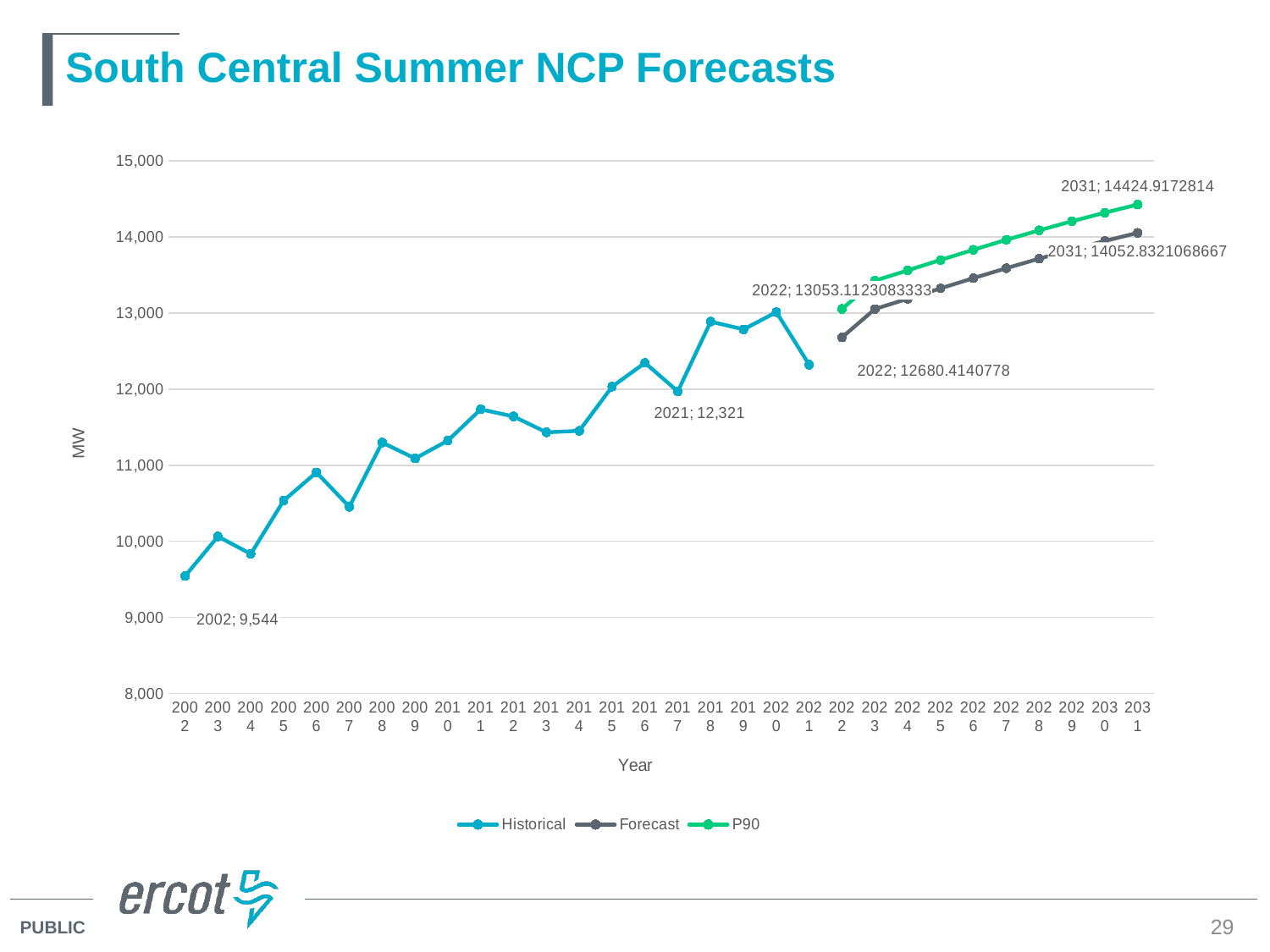
What is the Forecast value for 2022? 12680.4140778 Do the P90 values rise or fall from 2022 to 2031? Rise What kind of chart is shown on the slide? Line chart How many series does the legend list? 3 What is the Historical value for 2021? 12,321 What is the Historical value for 2002? 9,544 Is the Historical value for 2007 greater or less than 11,000? less What is the P90 value for 2022? 13053.1123083333 Is the Historical value for 2020 greater or less than 12,000? greater Which is larger in 2031, the P90 value or the Forecast value? P90 What is the P90 value for 2031? 14424.9172814 What is the Forecast value for 2031? 14052.8321068667